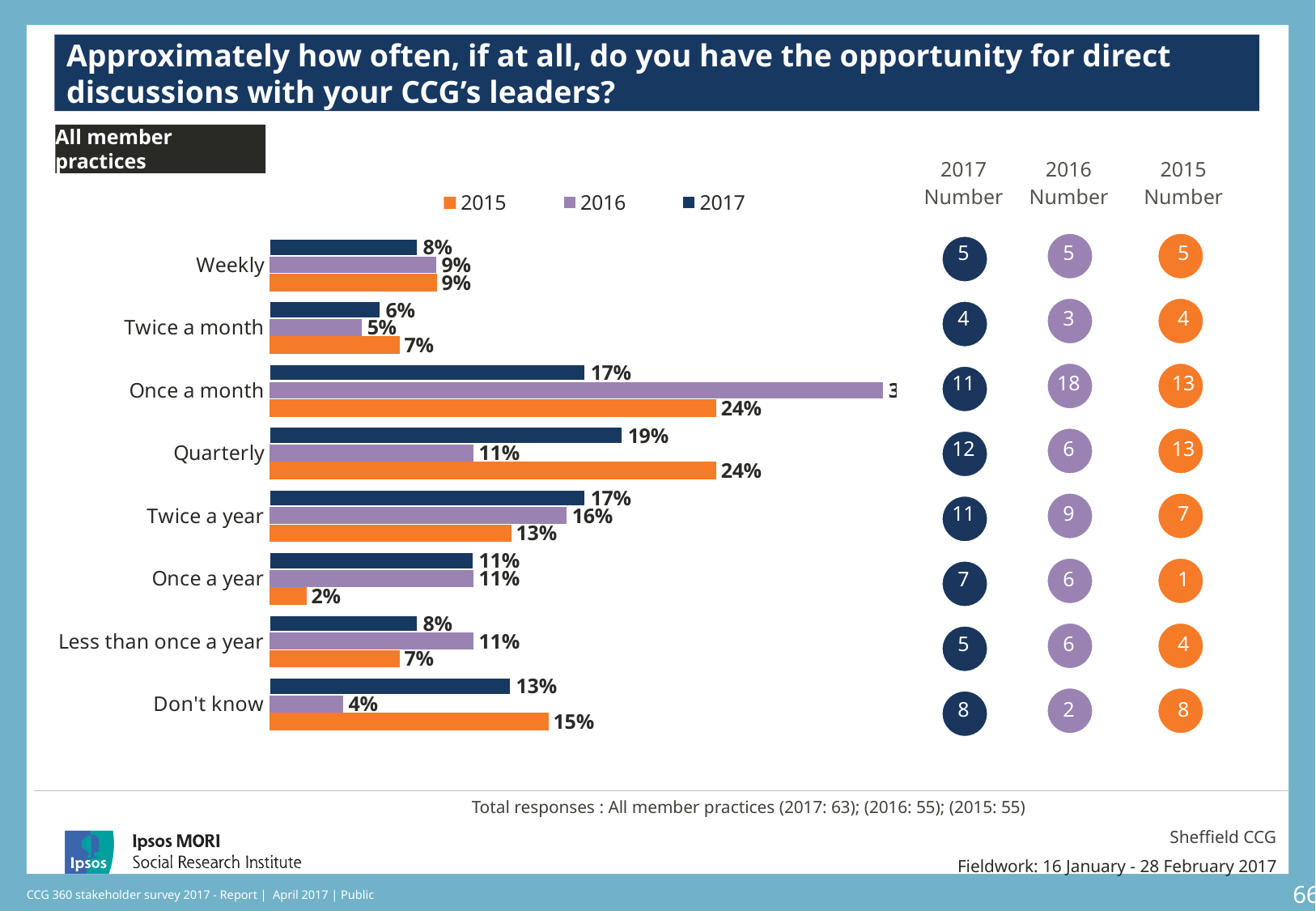
How many series does the chart legend list? 3 Which category has the lowest 2015 value? Once a year What is the 2017 value for Quarterly? 19% What is the 2016 value for Don't know? 4% What is the 2015 value for Once a year? 2% Which category has the highest 2017 value? Quarterly Which series is shown in orange in the legend? 2015 Which is larger for Don't know: the 2015 value or the 2017 value? 2015 How many categories are shown on the chart? 8 What is the difference between the 2015 and 2017 values for Once a month? 7% What is the 2017 value for Twice a month? 6% What kind of chart is shown on the slide? bar chart